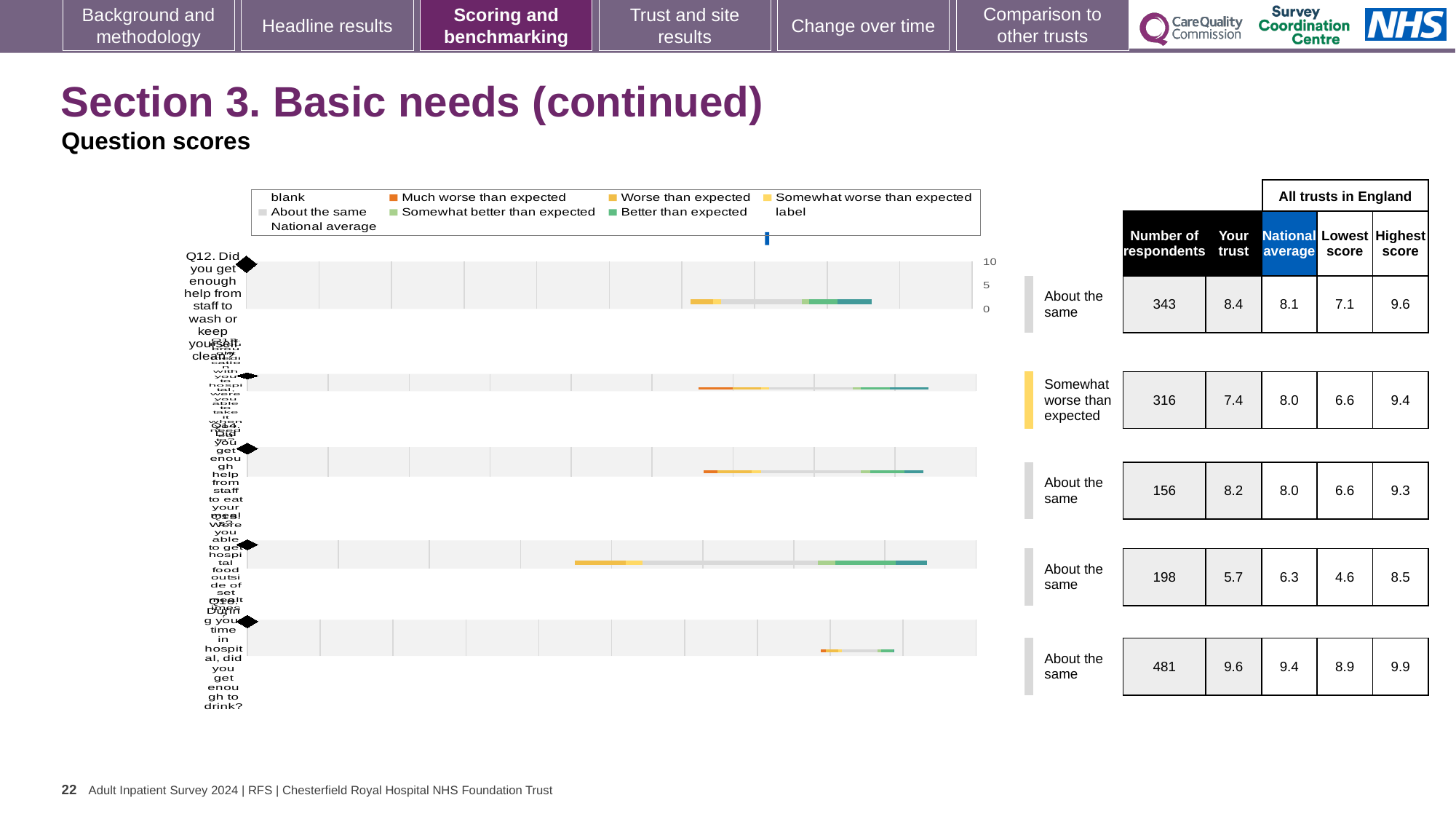
What benchmark category is shown for the second question row? Somewhat worse than expected Which question row has the highest 'Your trust' score? Q16 (did you get enough to drink) For Q12, what is the difference between the 'Your trust' score and the national average? 0.3 What is the lowest 'Your trust' score shown in the table? 5.7 What is the 'Your trust' score for Q14 (enough help from staff to eat your meals)? 8.2 What is the 'Your trust' score for Q12 (help from staff to wash or keep yourself clean)? 8.4 How many question rows are plotted in the chart? 5 What is the 'Your trust' score for Q16 (did you get enough to drink)? 9.6 What is the highest score across all trusts in England for Q16 (did you get enough to drink)? 9.9 For Q12, which is larger: the 'Your trust' score or the national average? Your trust How many respondents are listed for Q12 (help from staff to wash or keep yourself clean)? 343 What type of chart is used to show the question scores on this slide? bar chart